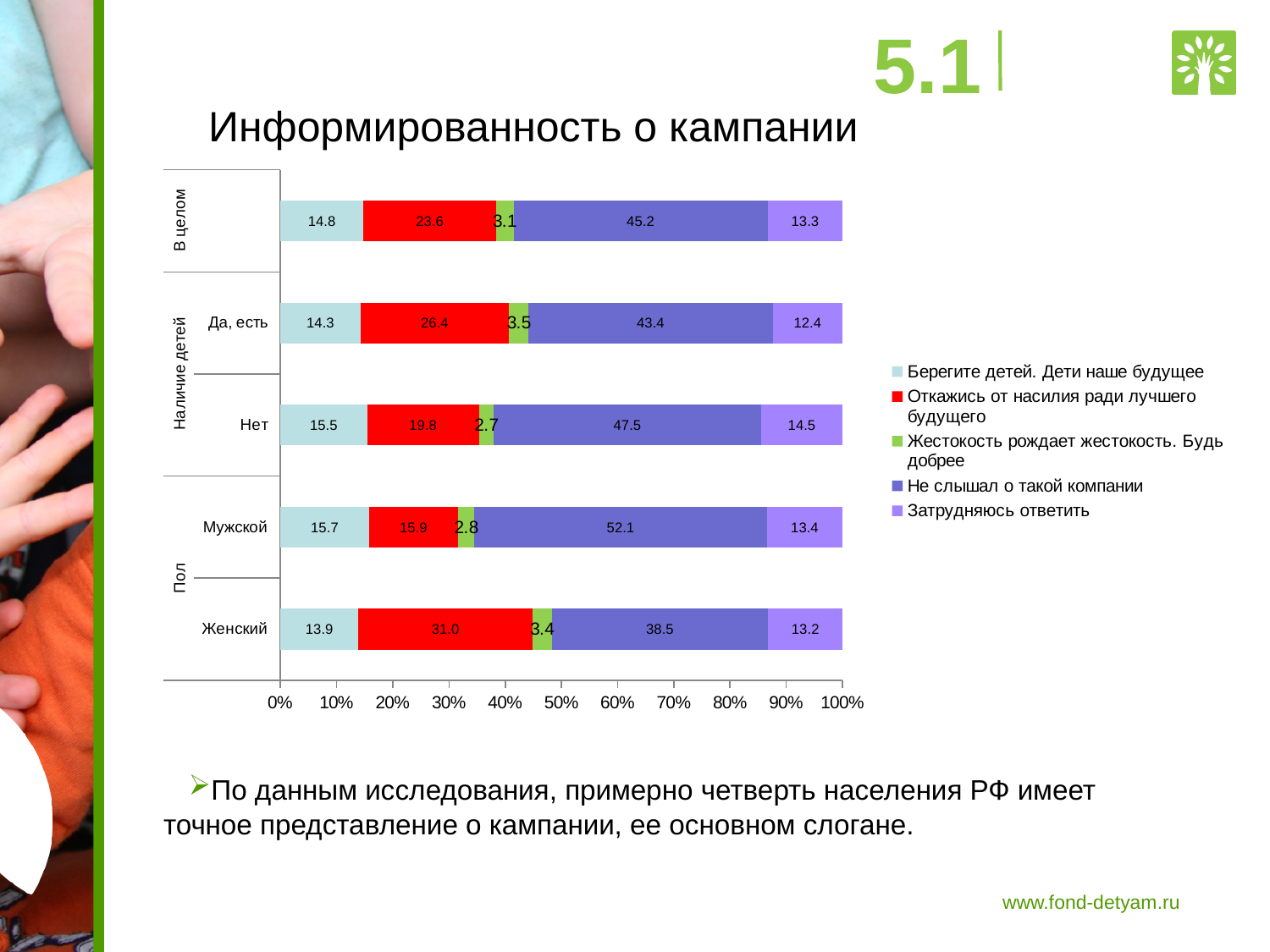
What is the value of "Берегите детей. Дети наше будущее" for the "Нет" bar? 15.5 What is the difference between the "Откажись от насилия ради лучшего будущего" values for "Женский" and "Мужской"? 15.1 What is the value of "Не слышал о такой компании" for the "В целом" bar? 45.2 Which category has the lowest value for "Откажись от насилия ради лучшего будущего"? Мужской What kind of chart is shown on the slide? Stacked bar chart Which category has the highest value for "Не слышал о такой компании"? Мужской How many series does the legend list? 5 What is the value of "Затрудняюсь ответить" for the "Да, есть" bar? 12.4 What is the value of "Откажись от насилия ради лучшего будущего" for the "Женский" bar? 31.0 What is the title of the chart? Информированность о кампании How many category bars are plotted in the chart? 5 Which is larger: the "Не слышал о такой компании" value for "Нет" or for "Да, есть"? Нет